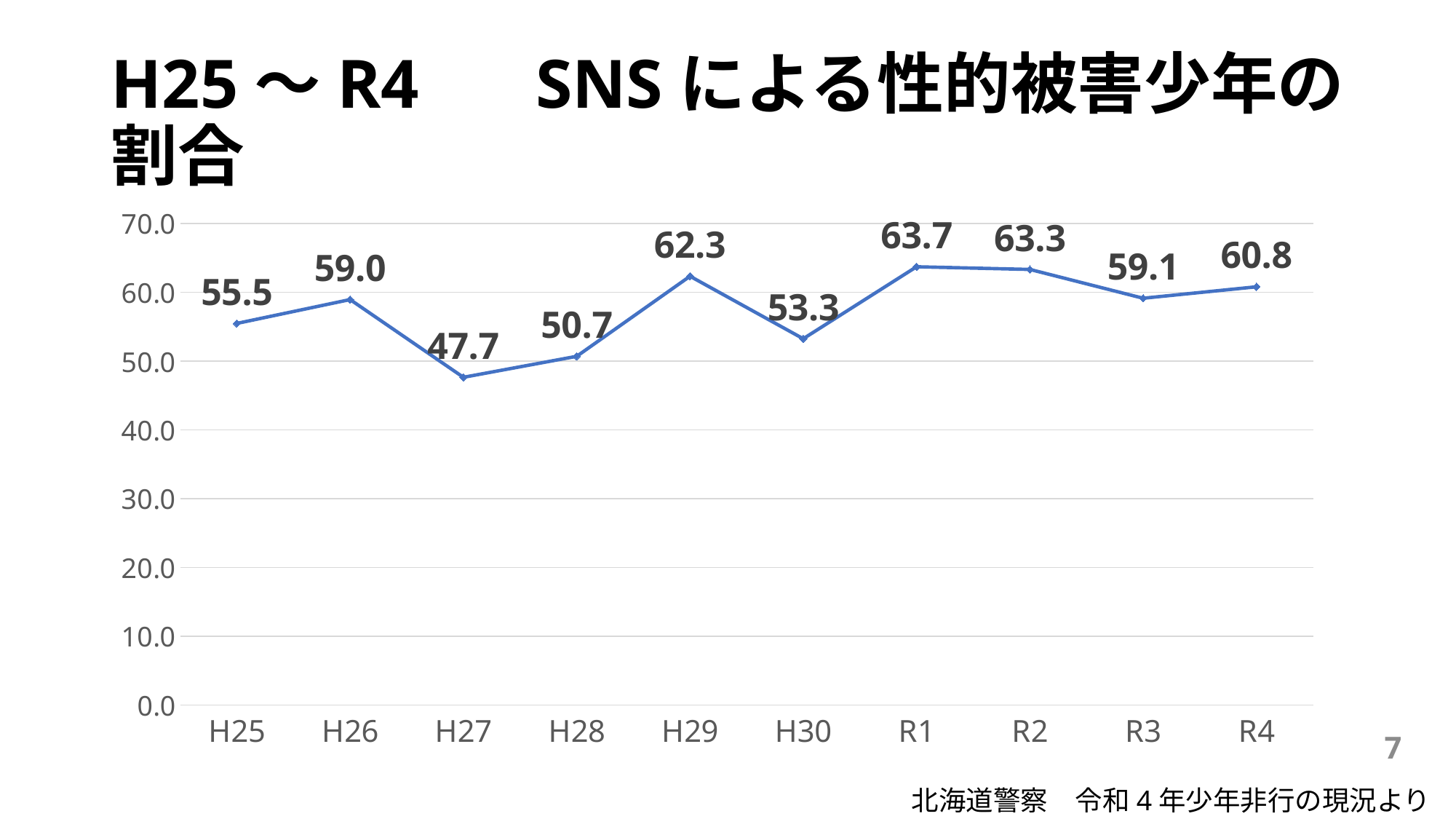
Which is larger, the value for H26 or the value for R3? R3 Which year has the highest value? R1 What is the value for R1? 63.7 What is the difference between the values for H29 and H30? 9.0 What kind of chart is shown on the slide? line chart What is the value for H25? 55.5 What is the difference between the values for R1 and H27? 16.0 How many years are plotted on the x axis? 10 Does the value rise or fall from H27 to H29? rise Which year has the lowest value? H27 Is the value for H28 greater or less than 60.0? less What is the value for H27? 47.7